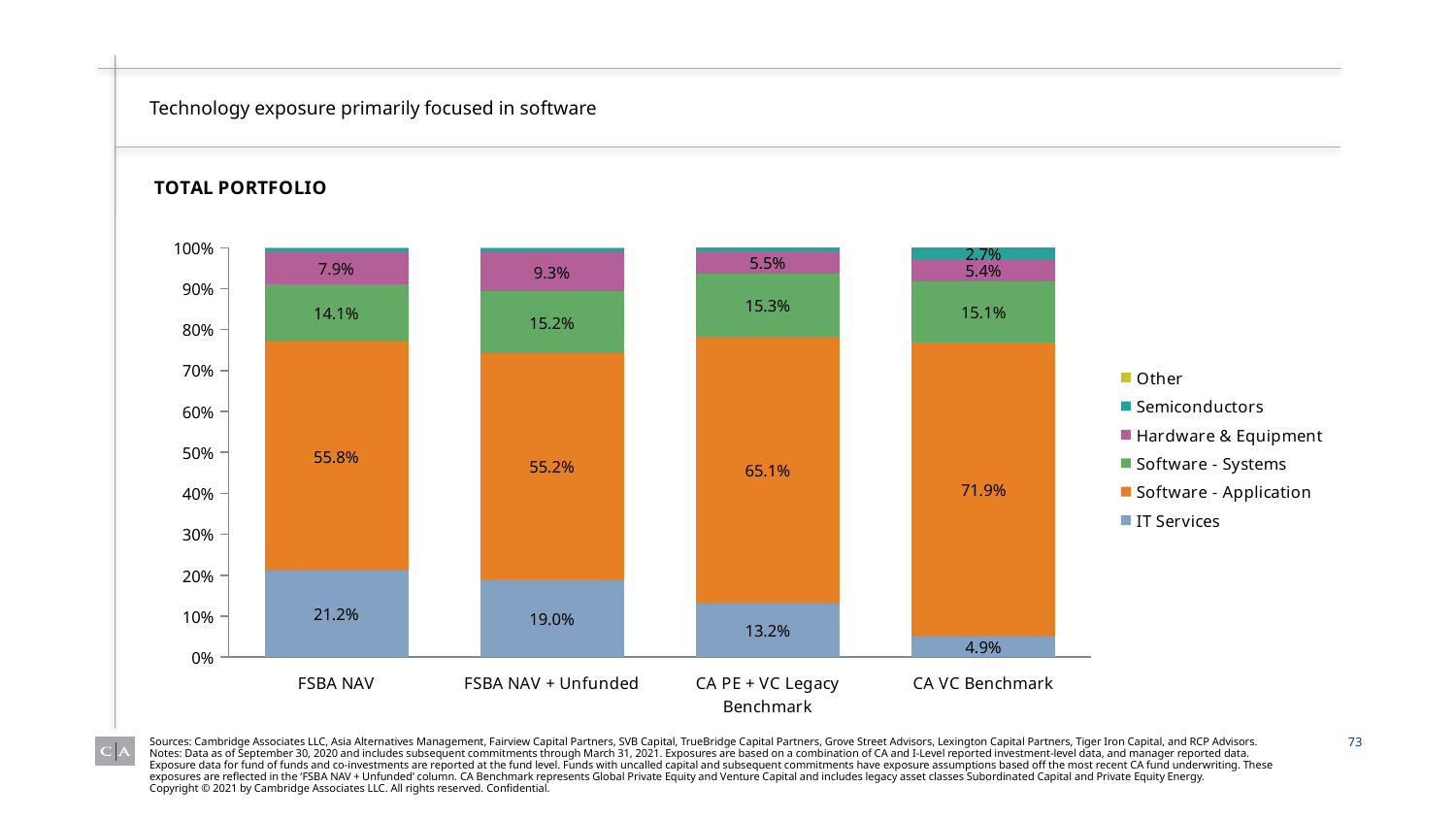
What is the Semiconductors share for CA VC Benchmark? 2.7% What is the difference between the Software - Application share for CA PE + VC Legacy Benchmark and for FSBA NAV? 9.3% What is the title shown above the chart? TOTAL PORTFOLIO How many categories are shown on the x axis? 4 What is the IT Services share for FSBA NAV? 21.2% Which is larger: the Software - Systems share for FSBA NAV + Unfunded or for FSBA NAV? FSBA NAV + Unfunded What is the Hardware & Equipment share for FSBA NAV + Unfunded? 9.3% What kind of chart is shown on the slide? Stacked bar chart Which category has the lowest IT Services share? CA VC Benchmark Which category has the highest Software - Application share? CA VC Benchmark What is the Software - Application share for CA VC Benchmark? 71.9% How many series does the legend list? 6